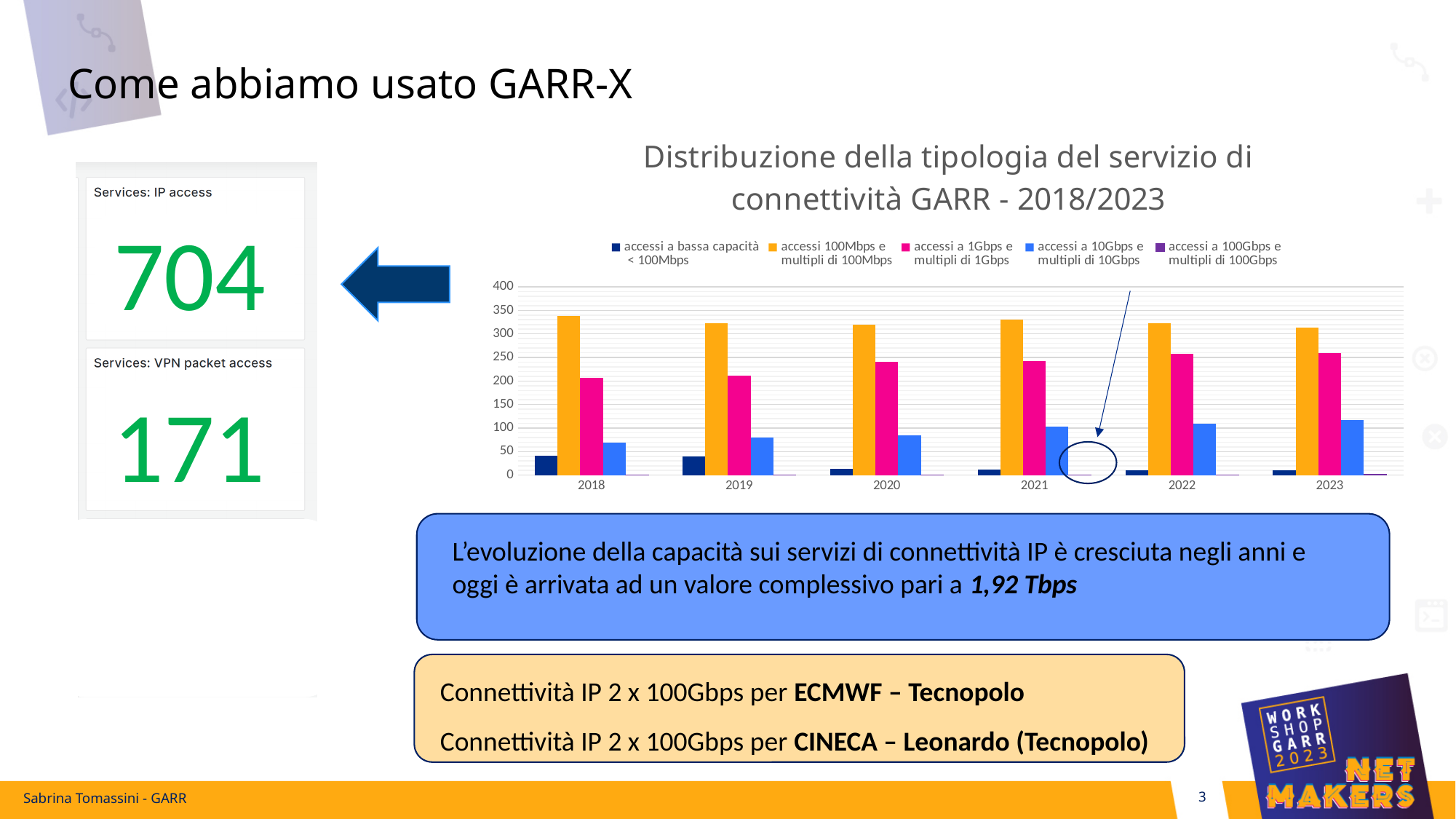
Which series has the tallest bar in 2018? accessi 100Mbps e multipli di 100Mbps How many years are shown along the x axis of the chart? 6 In 2022, which is larger: 'accessi a 1Gbps e multipli di 1Gbps' or 'accessi a 10Gbps e multipli di 10Gbps'? accessi a 1Gbps e multipli di 1Gbps Is the value for 'accessi a bassa capacità < 100Mbps' in 2021 greater or less than 50? less Does the value for 'accessi a 10Gbps e multipli di 10Gbps' rise or fall from 2018 to 2023? rise Is the value for 'accessi a 10Gbps e multipli di 10Gbps' in 2023 greater or less than 100? greater Is the value for 'accessi a 1Gbps e multipli di 1Gbps' in 2018 greater or less than 250? less What kind of chart is shown on the slide? bar chart How many series does the chart legend list? 5 What is the title of the chart? Distribuzione della tipologia del servizio di connettività GARR - 2018/2023 Does the value for 'accessi a bassa capacità < 100Mbps' rise or fall from 2018 to 2023? fall